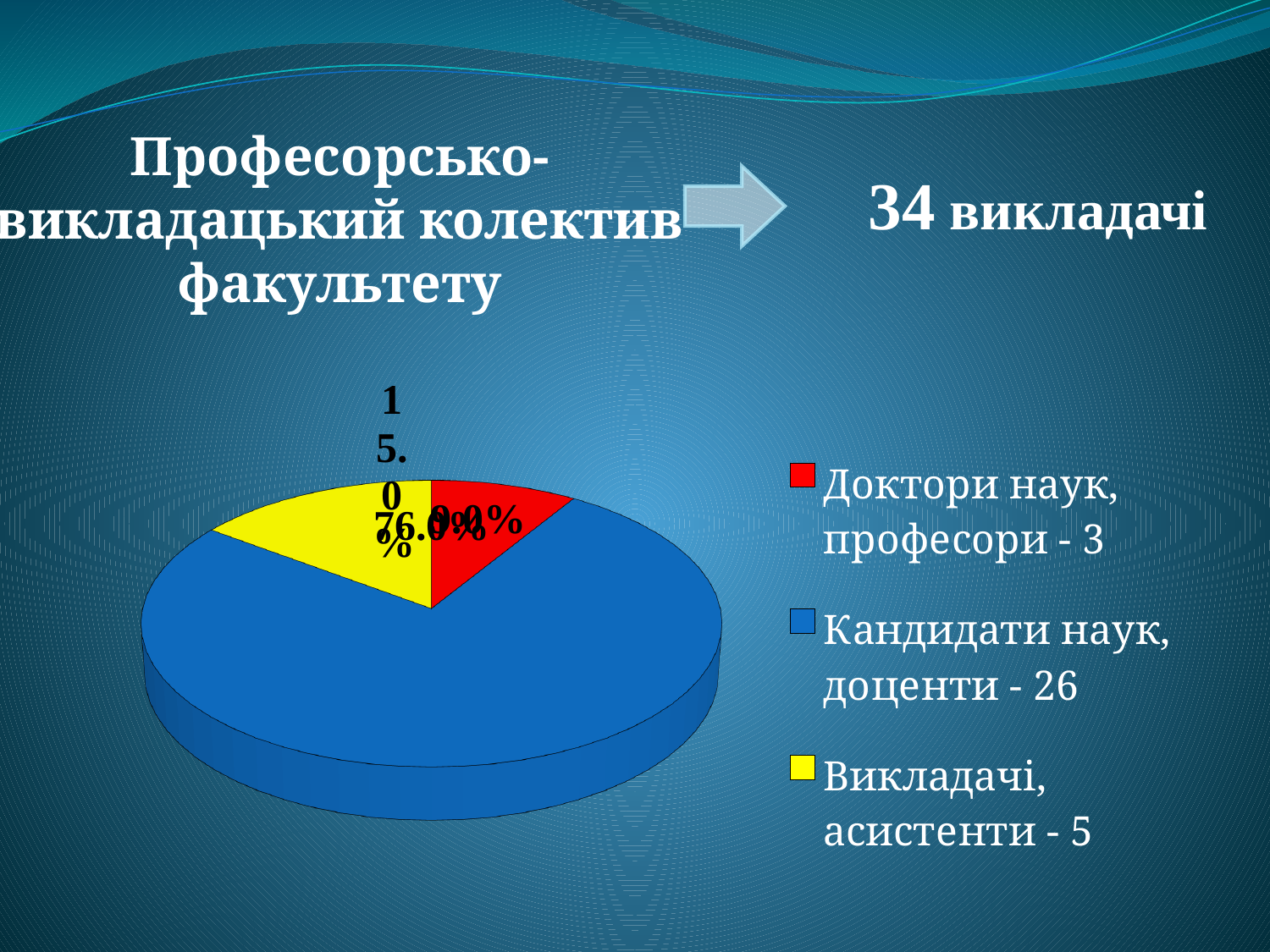
What colour is the slice for Викладачі, асистенти? yellow Which category has the smallest slice of the pie? Доктори наук, професори What is the difference between the number of Викладачі, асистенти and the number of Доктори наук, професори? 2 According to the legend, how many Кандидати наук, доценти are there? 26 Which slice is larger: Викладачі, асистенти or Доктори наук, професори? Викладачі, асистенти According to the legend, how many Викладачі, асистенти are there? 5 Which category has the largest slice of the pie? Кандидати наук, доценти What is the difference between the number of Кандидати наук, доценти and the number of Викладачі, асистенти? 21 According to the legend, how many Доктори наук, професори are there? 3 How many slices does the pie chart have? 3 What is the total number of teachers stated on the slide? 34 What kind of chart is shown on the slide? pie chart